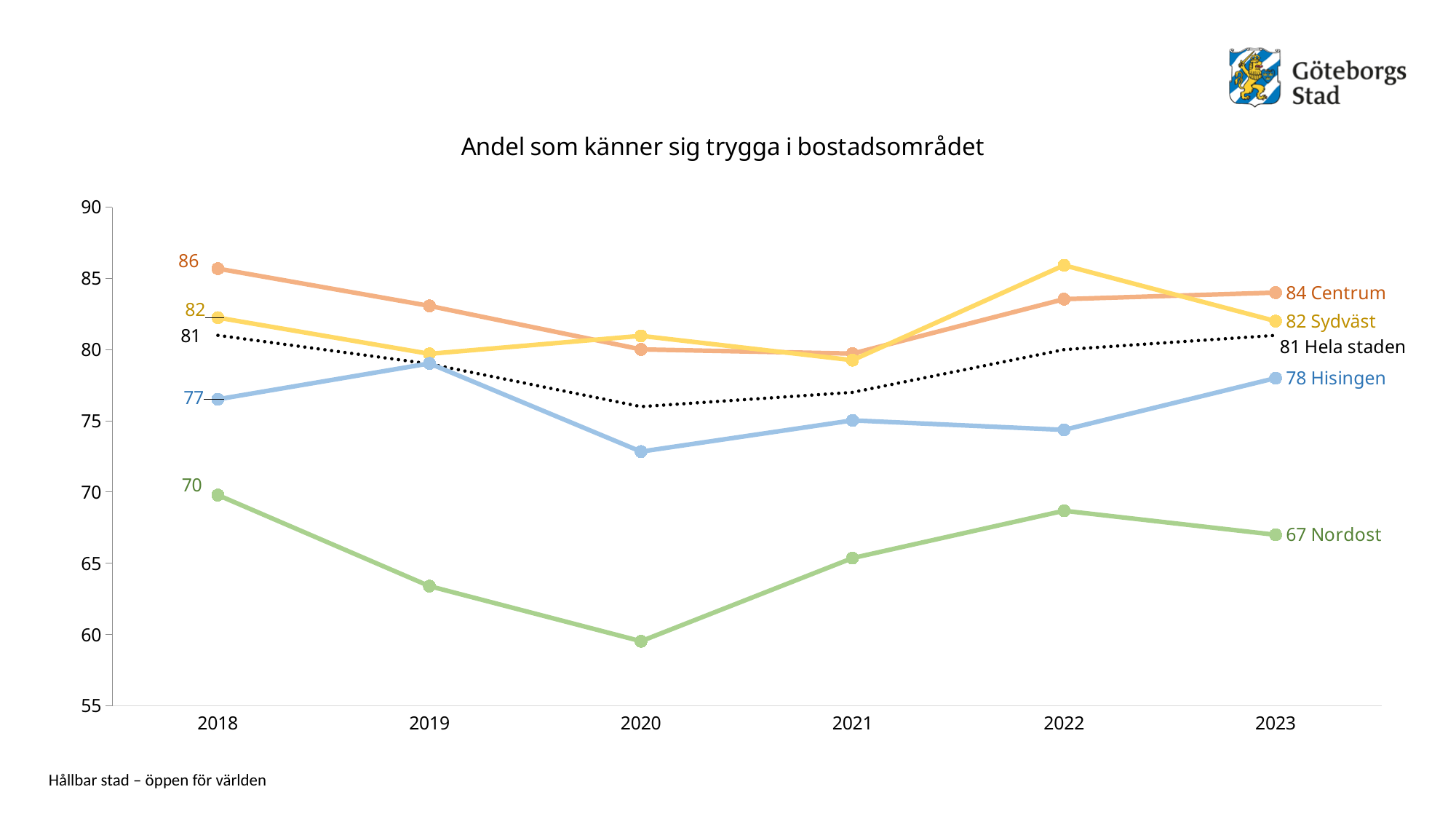
Which series has the lowest value in 2023? Nordost Which series has the highest value in 2018? Centrum What kind of chart is shown on the slide? line chart Is the value for Hisingen in 2020 greater or less than 75? less What is the difference between the Nordost value in 2018 and in 2023? 3 How many series (lines) are plotted on the chart? 5 By how much did the value for Centrum change between 2018 (86) and 2023 (84)? 2 What is the value for Nordost in 2023? 67 What is the title of the chart? Andel som känner sig trygga i bostadsområdet What is the value for Centrum in 2018? 86 What is the value for Hisingen in 2018? 77 What is the value for Hela staden in 2023? 81